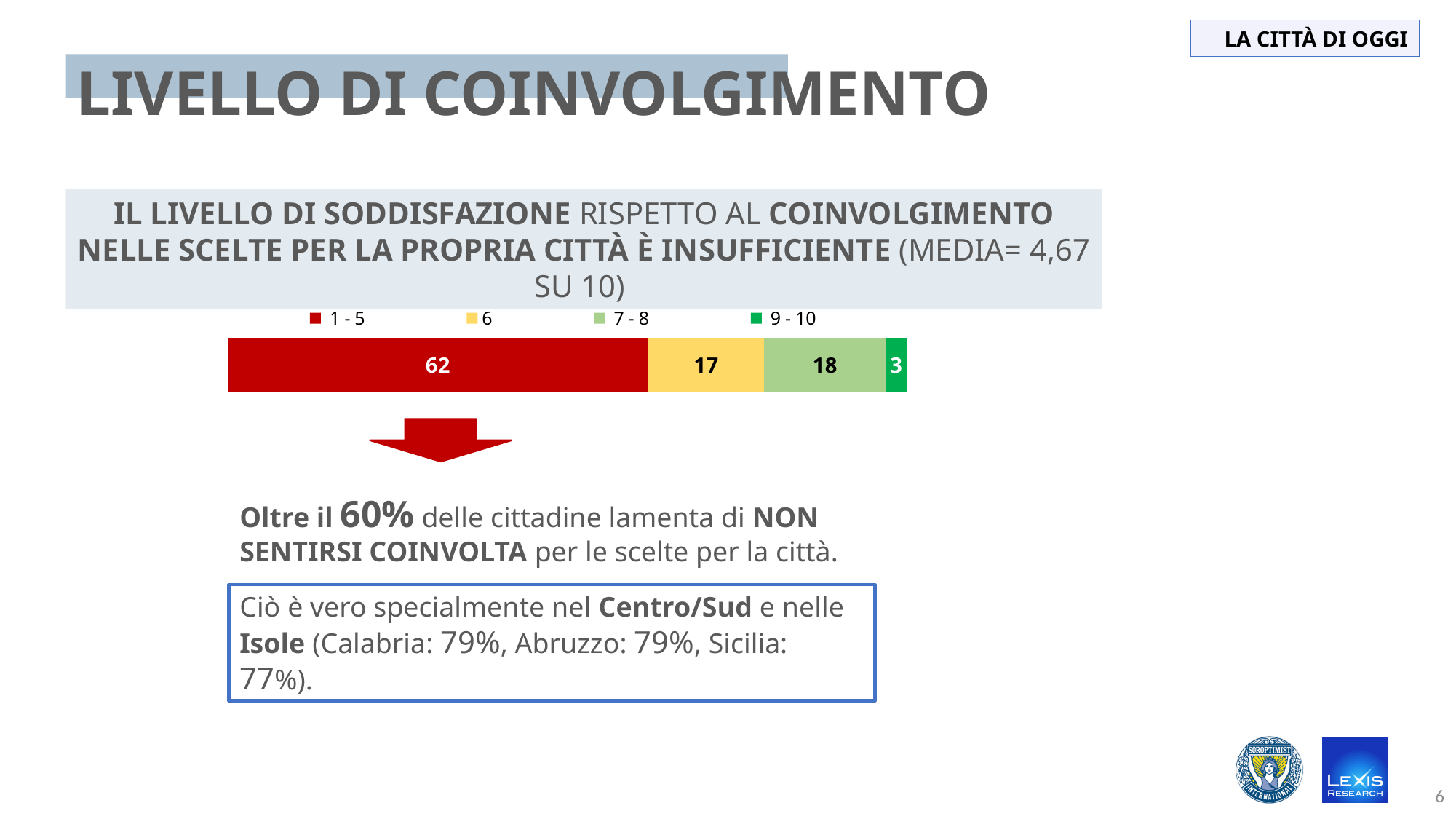
How many series does the legend list? 4 Which segment of the stacked bar has the lowest value? 9 - 10 What colour is the "1 - 5" segment of the bar? Red What value is shown for the "1 - 5" segment of the stacked bar? 62 What value is shown for the "7 - 8" segment of the stacked bar? 18 What is the total of all segments in the stacked bar? 100 Which is larger, the "6" segment or the "9 - 10" segment? 6 Which segment of the stacked bar has the highest value? 1 - 5 What kind of chart is shown on the slide? Stacked bar chart What value is shown for the "6" segment of the stacked bar? 17 What value is shown for the "9 - 10" segment of the stacked bar? 3 What is the difference between the "1 - 5" segment and the "7 - 8" segment? 44